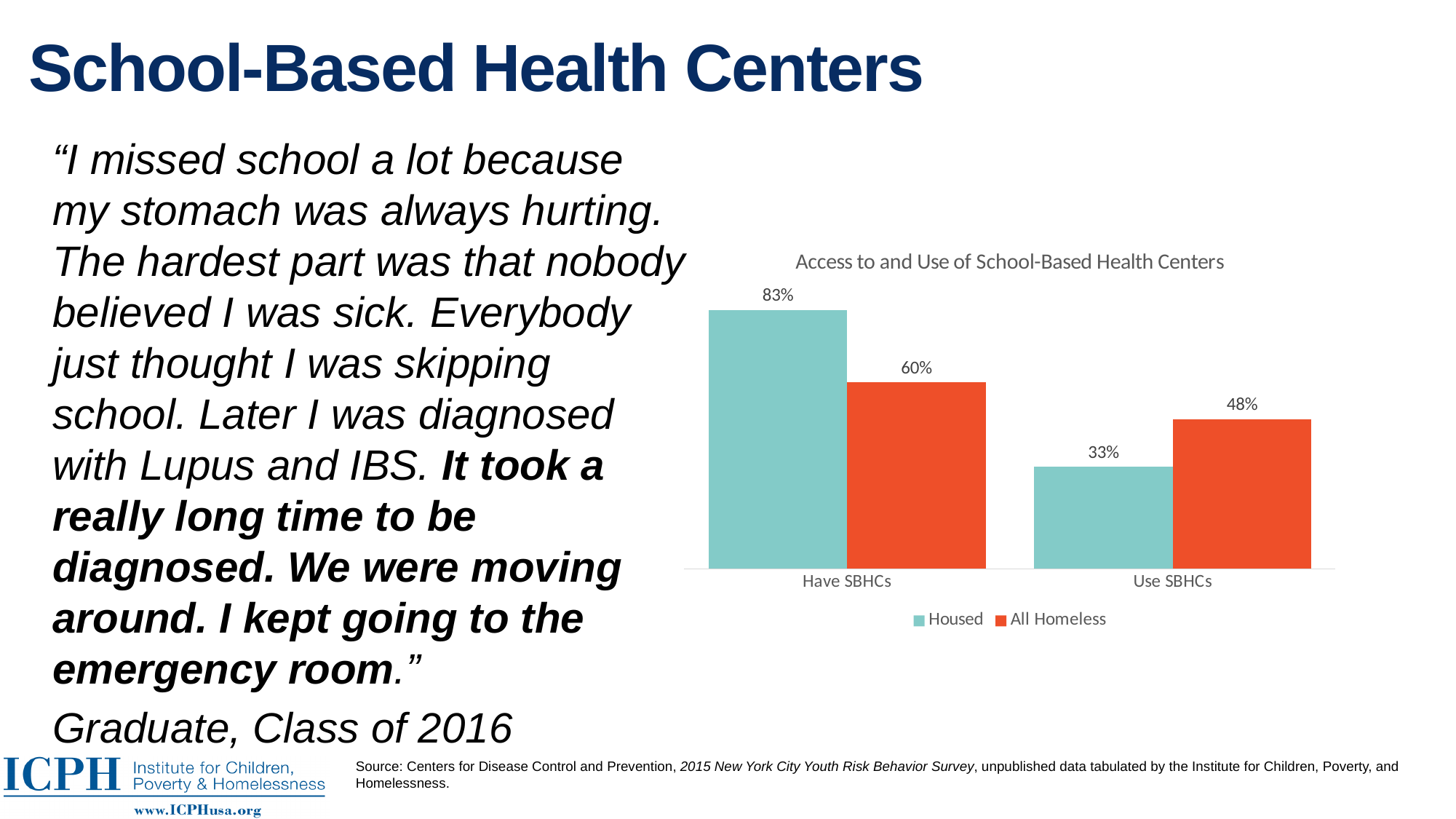
What percentage of Housed students use SBHCs? 33% Which group has the higher value for Use SBHCs, Housed or All Homeless? All Homeless What percentage of All Homeless students use SBHCs? 48% What is the difference between the All Homeless and Housed values for Use SBHCs? 15% Which bar in the chart has the lowest value? Housed, Use SBHCs (33%) What is the difference between the Housed and All Homeless values for Have SBHCs? 23% Which bar in the chart has the highest value? Housed, Have SBHCs (83%) How many series does the legend list? 2 What percentage of Housed students have SBHCs? 83% What percentage of All Homeless students have SBHCs? 60% Which group has the higher value for Have SBHCs, Housed or All Homeless? Housed What type of chart is shown on the slide? Bar chart